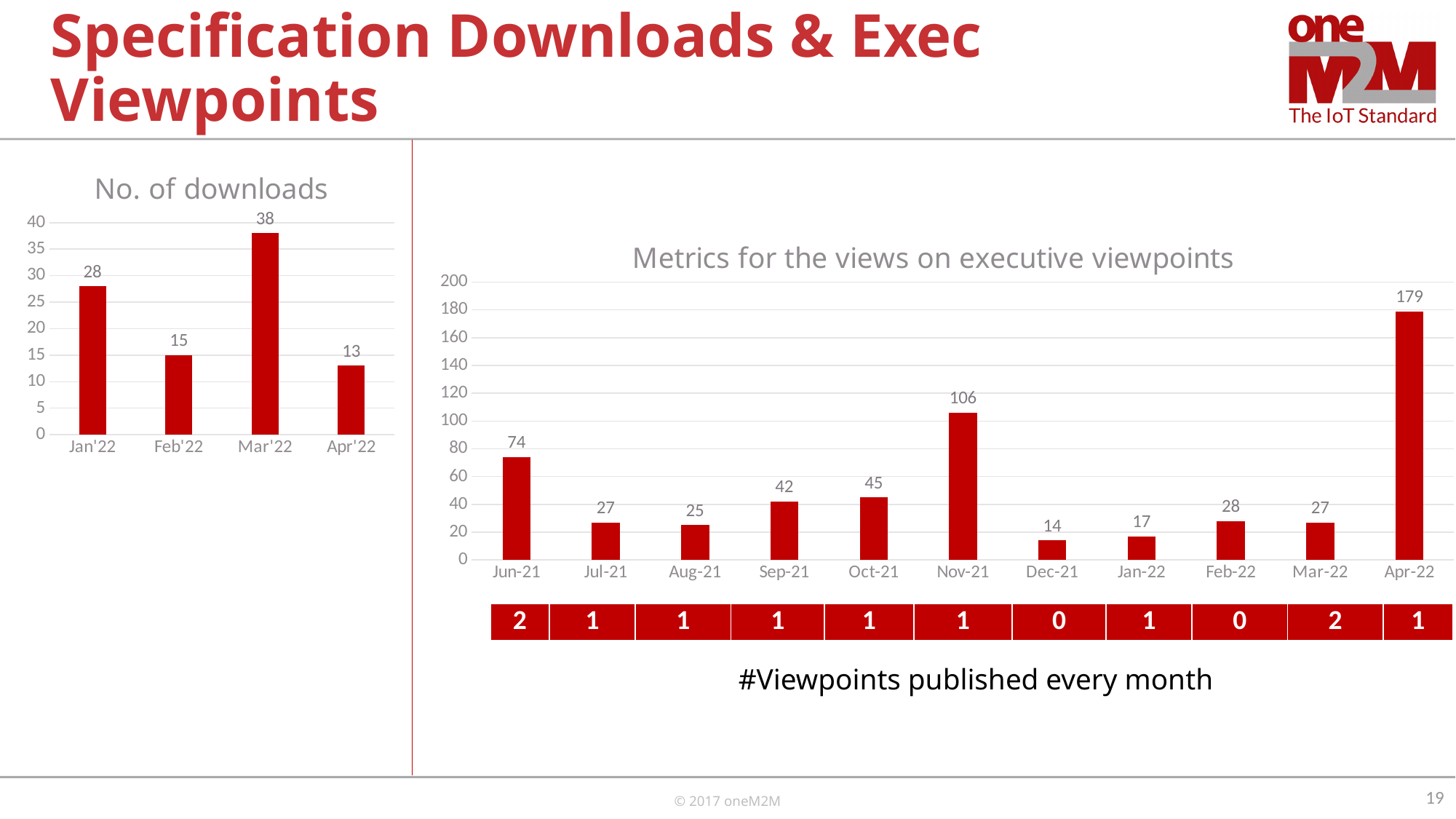
In the 'No. of downloads' chart, how many months are shown? 4 In the 'Metrics for the views on executive viewpoints' chart, which month has the lowest value? Dec-21 In the 'Metrics for the views on executive viewpoints' chart, which is larger, the value for Sep-21 or Oct-21? Oct-21 In the 'No. of downloads' chart, which month has the lowest number of downloads? Apr'22 What kind of chart is the 'Metrics for the views on executive viewpoints' chart? Bar chart In the 'No. of downloads' chart, what is the value for Mar'22? 38 In the 'Metrics for the views on executive viewpoints' chart, which month has the highest value? Apr-22 In the 'Metrics for the views on executive viewpoints' chart, what is the value for Jul-21? 27 In the 'Metrics for the views on executive viewpoints' chart, what is the value for Nov-21? 106 In the 'No. of downloads' chart, what is the difference between the values for Jan'22 and Feb'22? 13 In the 'Metrics for the views on executive viewpoints' chart, how many months are plotted? 11 In the 'Metrics for the views on executive viewpoints' chart, what is the difference between the values for Apr-22 and Nov-21? 73